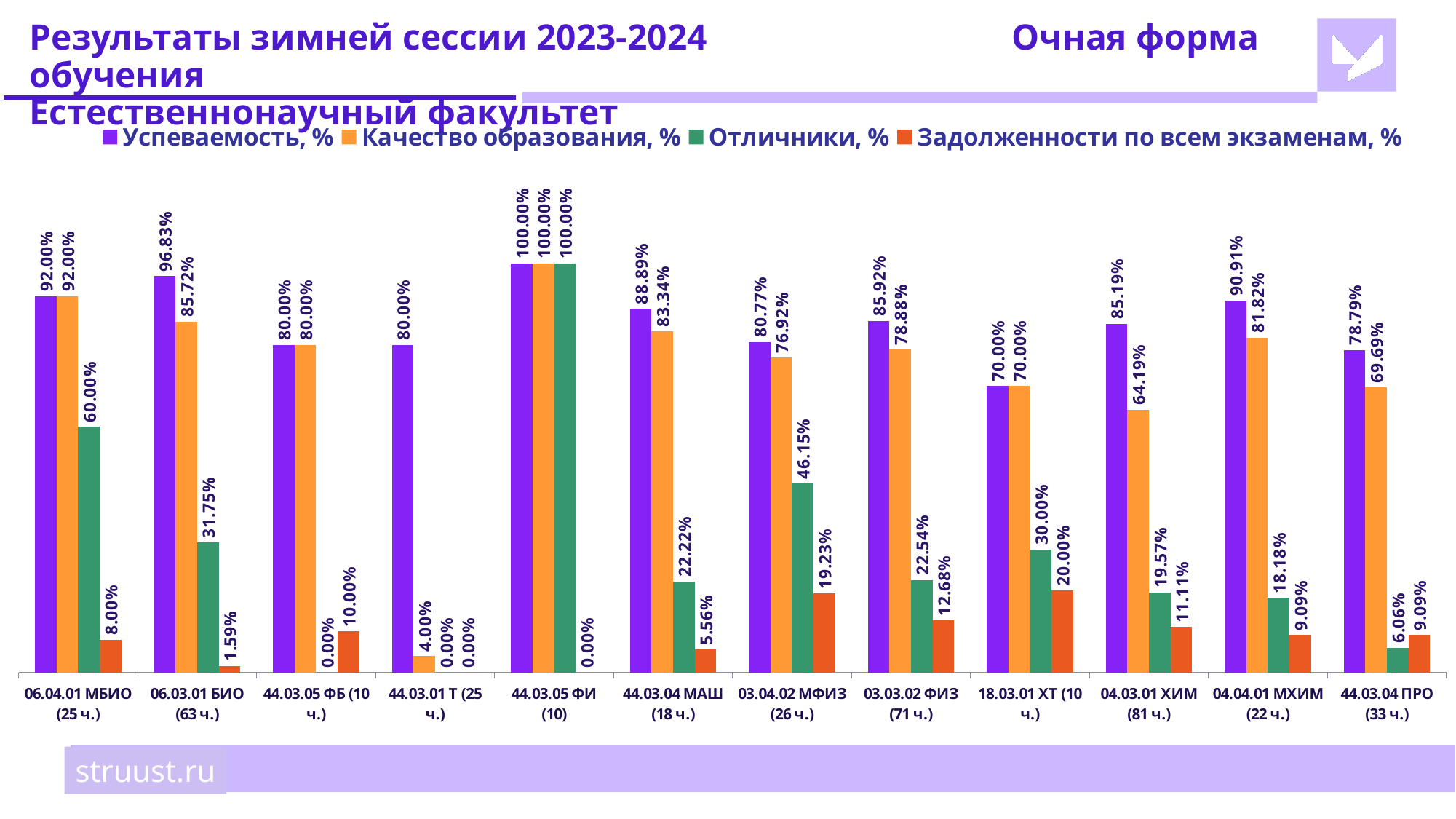
How many categories are shown on the x axis of the chart? 12 How many series does the legend list? 4 What is the difference between Успеваемость, % and Качество образования, % for 04.03.01 ХИМ (81 ч.)? 21.00% What is the value of Качество образования, % for 04.03.01 ХИМ (81 ч.)? 64.19% What is the value of Отличники, % for 03.04.02 МФИЗ (26 ч.)? 46.15% What is the value of Задолженности по всем экзаменам, % for 18.03.01 ХТ (10 ч.)? 20.00% What is the value of Успеваемость, % for 06.03.01 БИО (63 ч.)? 96.83% Which colour represents the series Отличники, % in the chart? Green What kind of chart is shown on the slide? Bar chart Which is larger: Отличники, % for 06.04.01 МБИО (25 ч.) or Отличники, % for 06.03.01 БИО (63 ч.)? 06.04.01 МБИО (25 ч.) Which category has the lowest value of Качество образования, %? 44.03.01 Т (25 ч.) Which category has the highest value of Успеваемость, %? 44.03.05 ФИ (10)